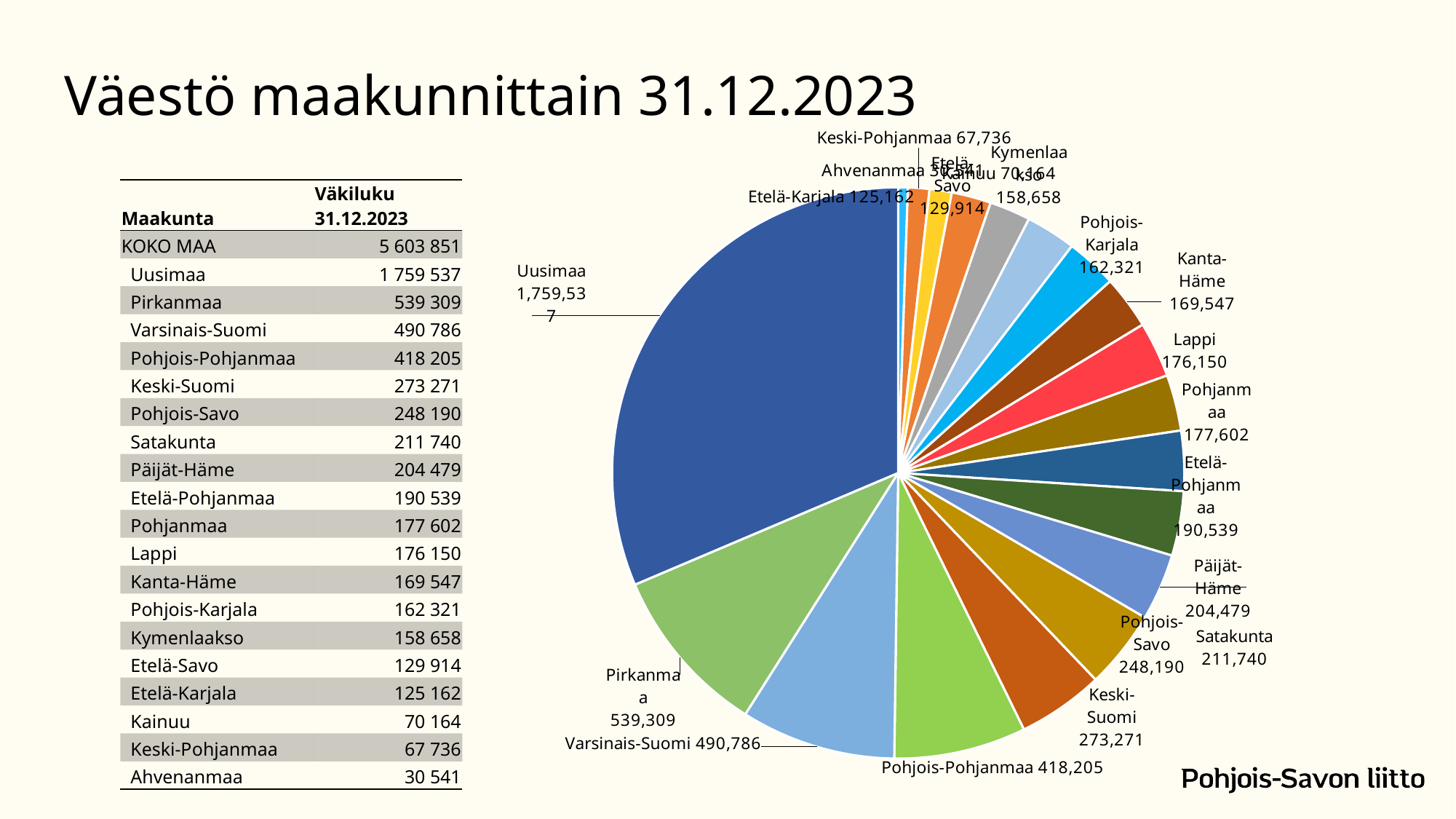
What is the difference between the values for Pirkanmaa and Varsinais-Suomi in the pie chart? 48,523 What is the title of the slide containing the pie chart? Väestö maakunnittain 31.12.2023 Which region has the largest slice in the pie chart? Uusimaa Which region has the smallest slice in the pie chart? Ahvenanmaa What is the value shown for Pirkanmaa in the pie chart? 539,309 What is the value shown for Pohjois-Savo in the pie chart? 248,190 What type of chart is shown on the slide? Pie chart What is the value shown for Keski-Pohjanmaa in the pie chart? 67,736 How many regions (slices) are shown in the pie chart? 19 Which has a larger value in the pie chart, Satakunta or Päijät-Häme? Satakunta What is the difference between the values for Keski-Suomi and Pohjois-Savo in the pie chart? 25,081 What is the value shown for Lappi in the pie chart? 176,150